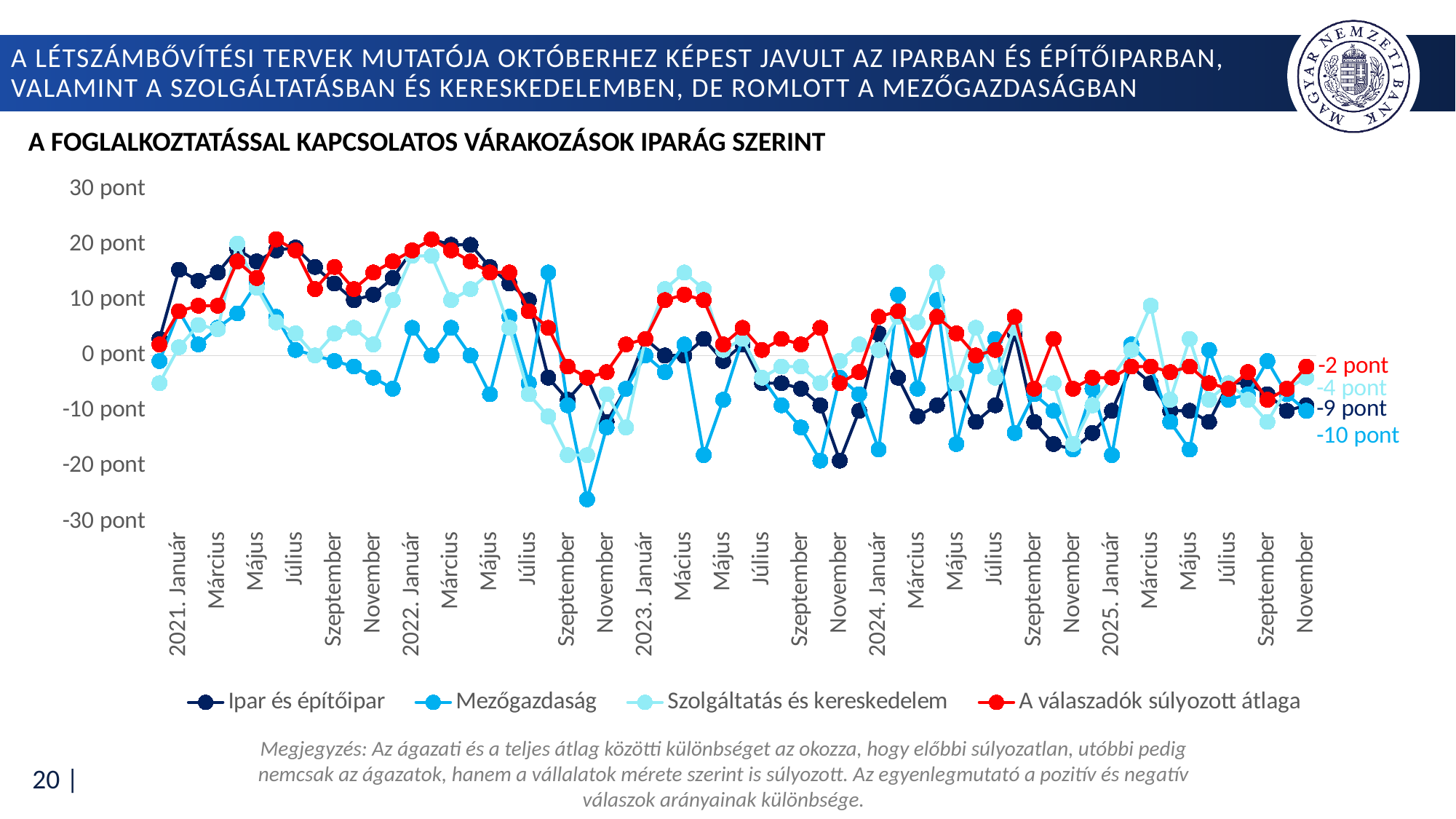
At the last point (2025 November), which is larger: 'Ipar és építőipar' or 'Szolgáltatás és kereskedelem'? Szolgáltatás és kereskedelem Is the value for 'A válaszadók súlyozott átlaga' in 2021 July greater or less than 10 pont? greater What is the difference between 'A válaszadók súlyozott átlaga' and 'Mezőgazdaság' at the last point (2025 November)? 8 pont What is the value for 'Mezőgazdaság' at the last point (2025 November)? -10 pont Which series has the lowest value at the last point (2025 November)? Mezőgazdaság What is the value for 'Szolgáltatás és kereskedelem' at the last point (2025 November)? -4 pont What is the value for 'A válaszadók súlyozott átlaga' at the last point (2025 November)? -2 pont How many series does the legend list? 4 Which series has the highest value at the last point (2025 November)? A válaszadók súlyozott átlaga Is the value for 'Mezőgazdaság' in 2022 October greater or less than -20 pont? less What kind of chart is shown on the slide? Line chart What is the value for 'Ipar és építőipar' at the last point (2025 November)? -9 pont